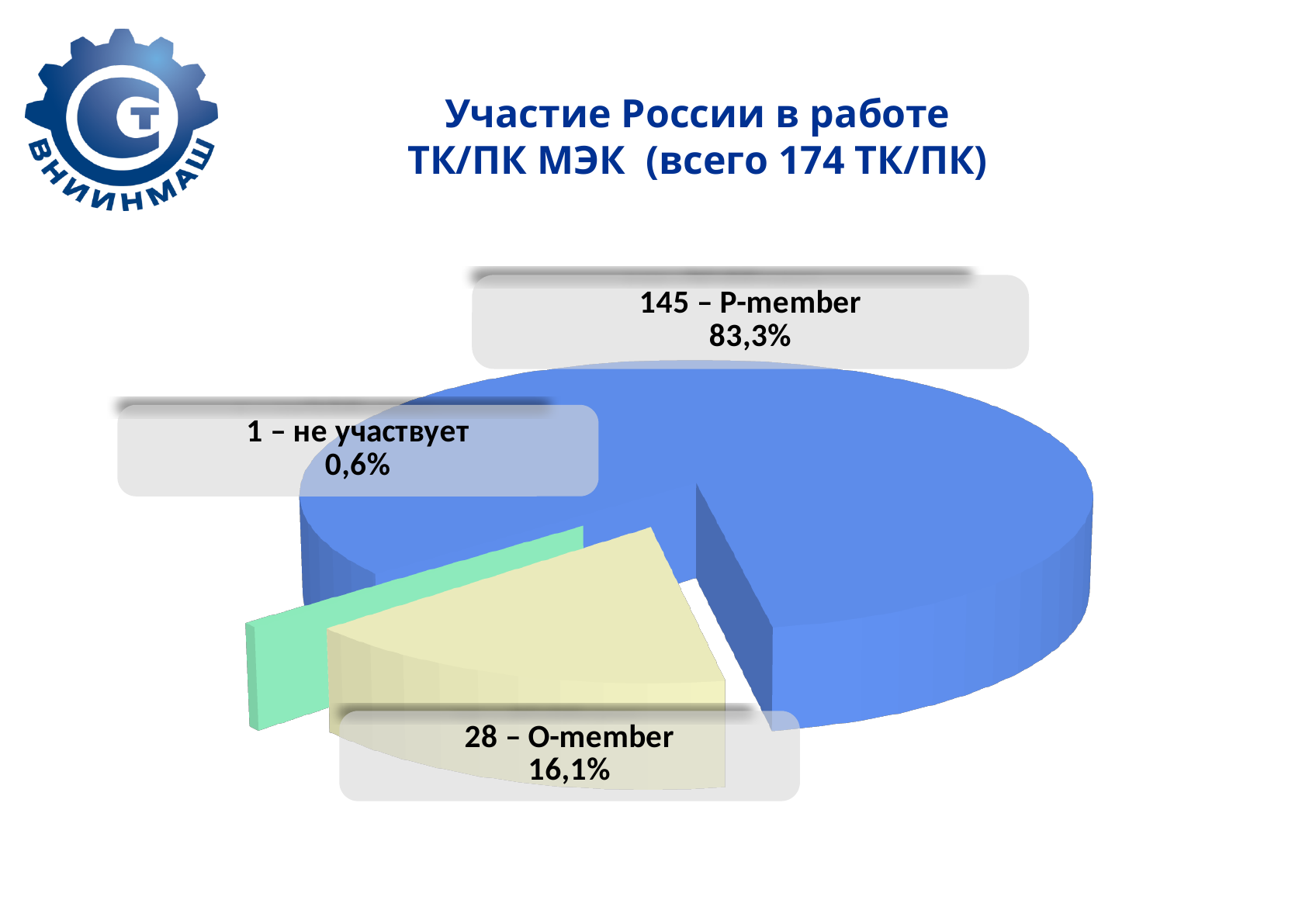
What percentage share does the O-member slice have? 16,1% Which category has the smallest slice of the pie? не участвует Which is larger, the O-member slice or the 'не участвует' slice? O-member How many slices does the pie chart have? 3 What kind of chart is shown on the slide? pie chart Which category has the largest slice of the pie? P-member What percentage share does the P-member slice have? 83,3% How many TC/SCs does the P-member slice represent? 145 How many TC/SCs does the O-member slice represent? 28 What is the total number of TC/SCs stated in the chart title? 174 What is the difference in count between the P-member and O-member slices? 117 What percentage share does the 'не участвует' slice have? 0,6%